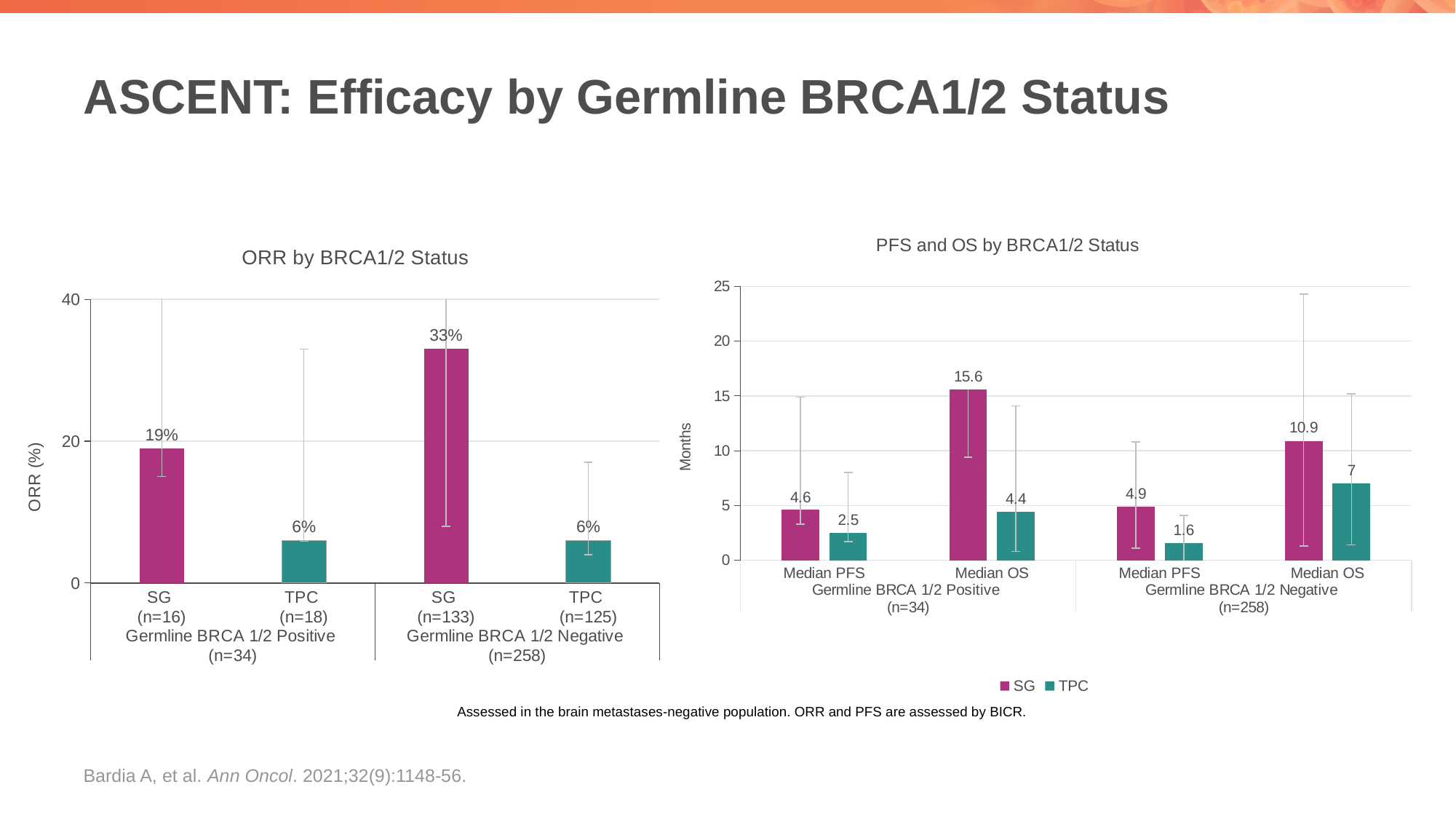
In the 'PFS and OS by BRCA1/2 Status' chart, which bar has the lowest value? TPC Median PFS, Germline BRCA 1/2 Negative (1.6) In the 'ORR by BRCA1/2 Status' chart, what is the ORR for SG in the Germline BRCA 1/2 Positive group? 19% In the 'PFS and OS by BRCA1/2 Status' chart, which is larger: median PFS for SG in the BRCA 1/2 Positive group or median PFS for SG in the BRCA 1/2 Negative group? BRCA 1/2 Negative (4.9) In the 'PFS and OS by BRCA1/2 Status' chart, what is the median OS for SG in the Germline BRCA 1/2 Positive group? 15.6 In the 'ORR by BRCA1/2 Status' chart, what is the ORR for TPC in the Germline BRCA 1/2 Negative group? 6% How many series does the legend of the 'PFS and OS by BRCA1/2 Status' chart list? 2 In the 'ORR by BRCA1/2 Status' chart, how many bars are plotted? 4 In the 'ORR by BRCA1/2 Status' chart, what is the difference in ORR between SG and TPC in the Germline BRCA 1/2 Positive group? 13% What type of chart is the 'PFS and OS by BRCA1/2 Status' chart? Bar chart In the 'ORR by BRCA1/2 Status' chart, which bar has the highest ORR? SG, Germline BRCA 1/2 Negative In the 'PFS and OS by BRCA1/2 Status' chart, what is the median PFS for TPC in the Germline BRCA 1/2 Negative group? 1.6 In the 'PFS and OS by BRCA1/2 Status' chart, what is the difference in median OS between SG and TPC in the Germline BRCA 1/2 Negative group? 3.9